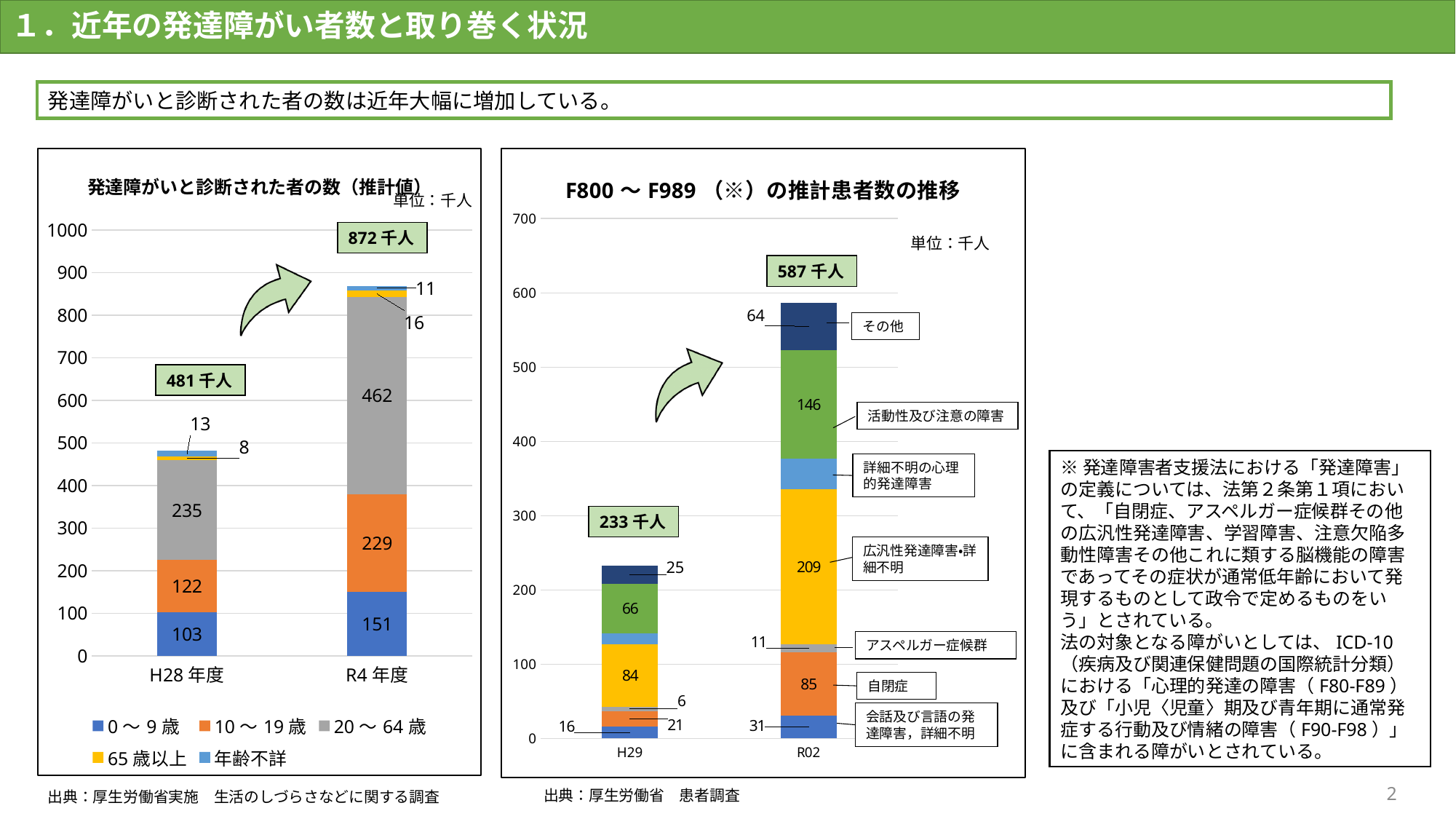
In the right chart (F800～F989（※）の推計患者数の推移), is the total for H29 greater or less than 300? less In the left chart (発達障がいと診断された者の数（推計値）), which age group has the largest value in H28年度? 20～64歳 In the left chart (発達障がいと診断された者の数（推計値）), what is the value for 0～9歳 in H28年度? 103 In the left chart (発達障がいと診断された者の数（推計値）), how many series does the legend list? 5 In the right chart (F800～F989（※）の推計患者数の推移), what is the value for 自閉症 in R02? 85 In the right chart (F800～F989（※）の推計患者数の推移), which is larger in R02: 広汎性発達障害・詳細不明 or 活動性及び注意の障害? 広汎性発達障害・詳細不明 In the right chart (F800～F989（※）の推計患者数の推移), what is the total for the R02 bar? 587千人 In the right chart (F800～F989（※）の推計患者数の推移), what is the value for 活動性及び注意の障害 in H29? 66 In the left chart (発達障がいと診断された者の数（推計値）), what is the total for the R4年度 bar? 872千人 In the left chart (発達障がいと診断された者の数（推計値）), what is the value for 20～64歳 in R4年度? 462 In the left chart (発達障がいと診断された者の数（推計値）), what is the difference between the 10～19歳 values for R4年度 and H28年度? 107 What kind of chart is the left chart (発達障がいと診断された者の数（推計値）)? Stacked bar chart